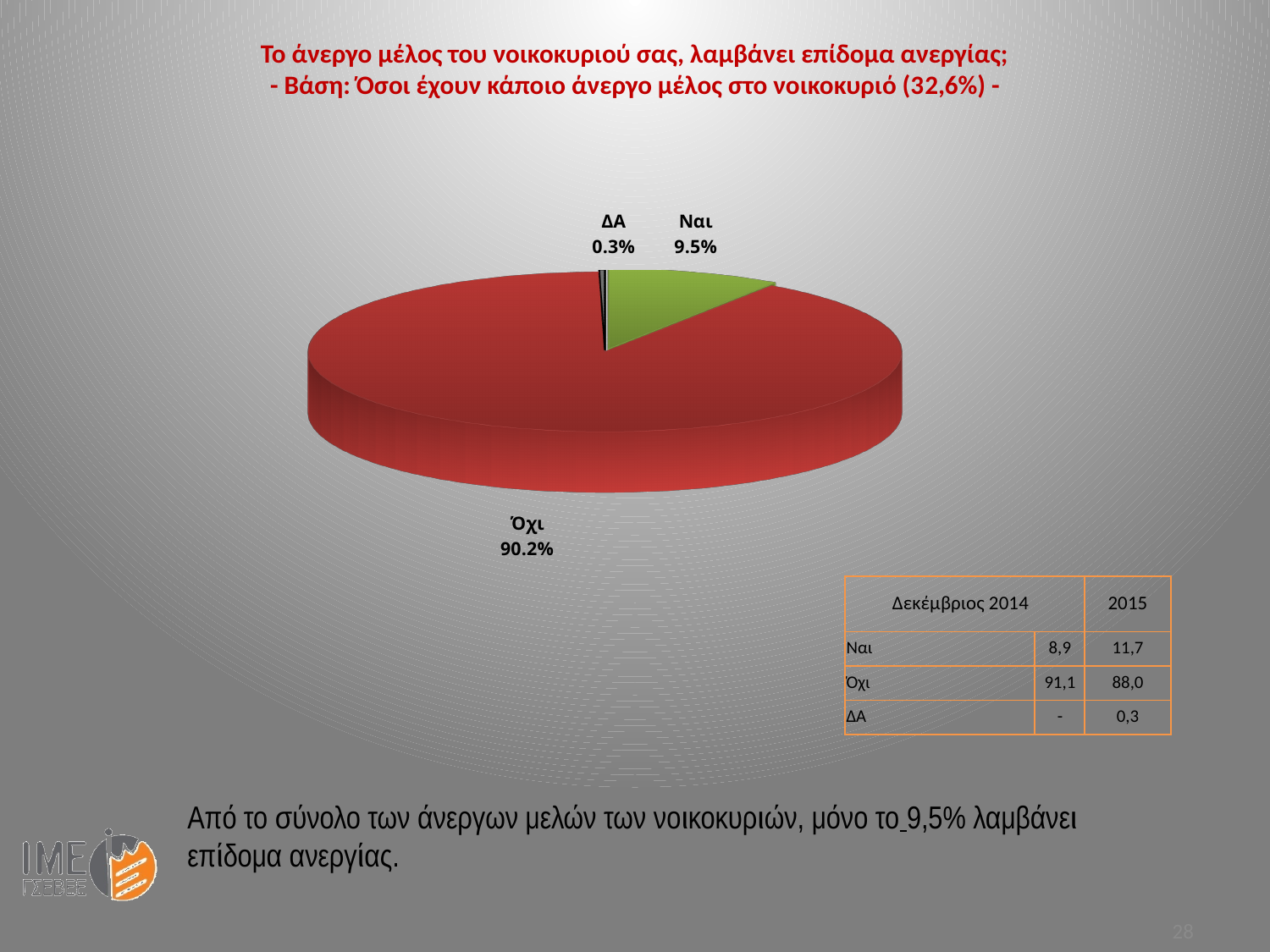
What colour is the Όχι slice of the pie chart? red What percentage does the Ναι slice of the pie chart show? 9.5% What percentage does the ΔΑ slice of the pie chart show? 0.3% What is the difference in percentage points between the Όχι and Ναι slices of the pie chart? 80.7 Which is larger in the pie chart, Ναι or ΔΑ? Ναι How many slices does the pie chart have? 3 What colour is the Ναι slice of the pie chart? green What kind of chart is shown on the slide? pie chart What percentage does the Όχι slice of the pie chart show? 90.2% Which slice of the pie chart is the largest? Όχι What is the difference in percentage points between the Ναι and ΔΑ slices of the pie chart? 9.2 Which slice of the pie chart is the smallest? ΔΑ